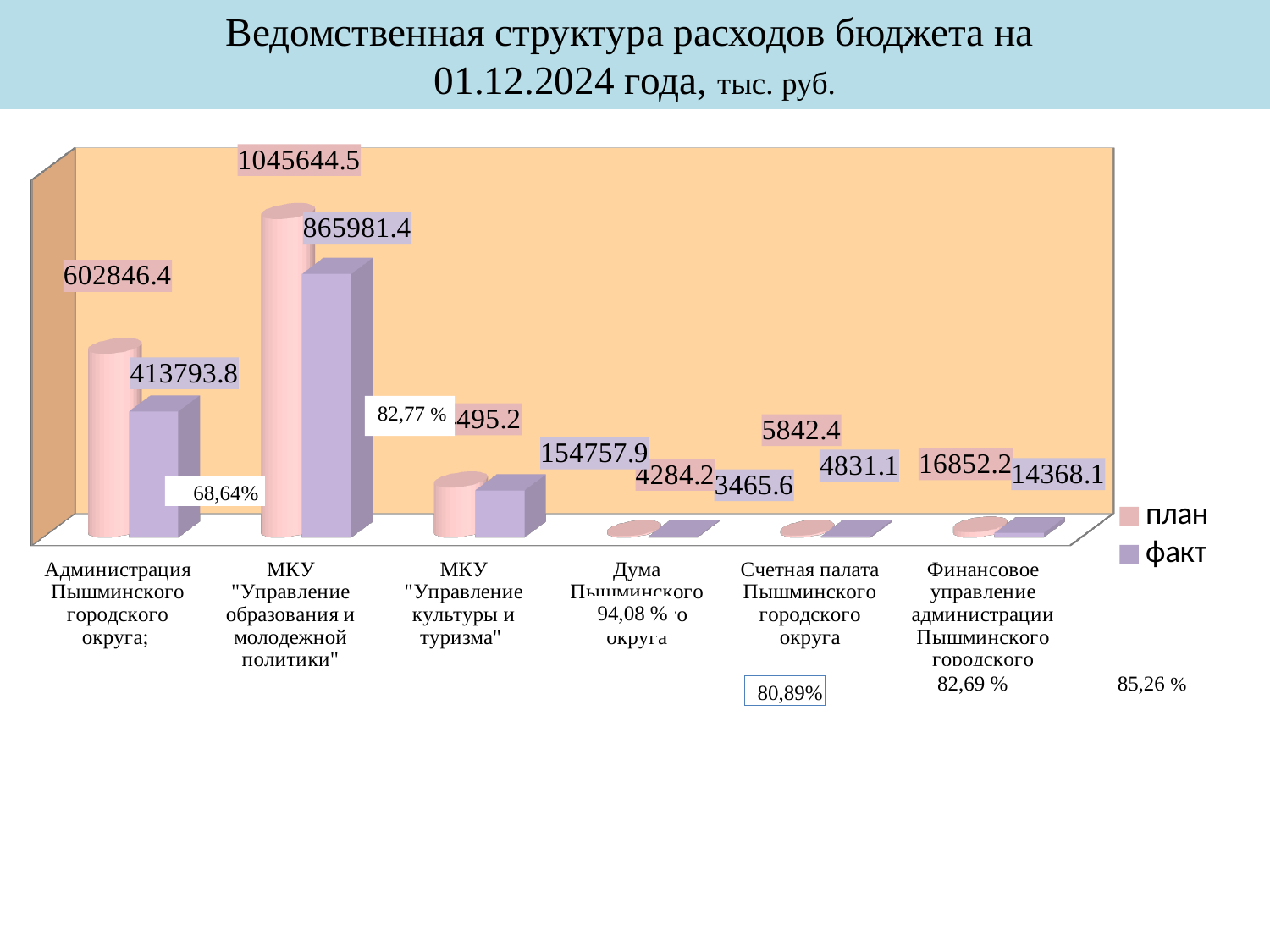
Which category has the highest план value? МКУ "Управление образования и молодежной политики" What is the факт value for Администрация Пышминского городского округа? 413793.8 How many categories are shown on the x axis? 6 What is the план value for Дума Пышминского городского округа? 4284.2 How many series does the legend list? 2 What kind of chart is shown on the slide? bar chart What is the факт value for МКУ "Управление образования и молодежной политики"? 865981.4 What is the план value for МКУ "Управление образования и молодежной политики"? 1045644.5 What is the difference between the план and факт values for Администрация Пышминского городского округа? 189052.6 Which has the larger план value: Финансовое управление администрации Пышминского городского округа or Счетная палата Пышминского городского округа? Финансовое управление администрации Пышминского городского округа What is the факт value for Счетная палата Пышминского городского округа? 4831.1 What is the план value for Администрация Пышминского городского округа? 602846.4